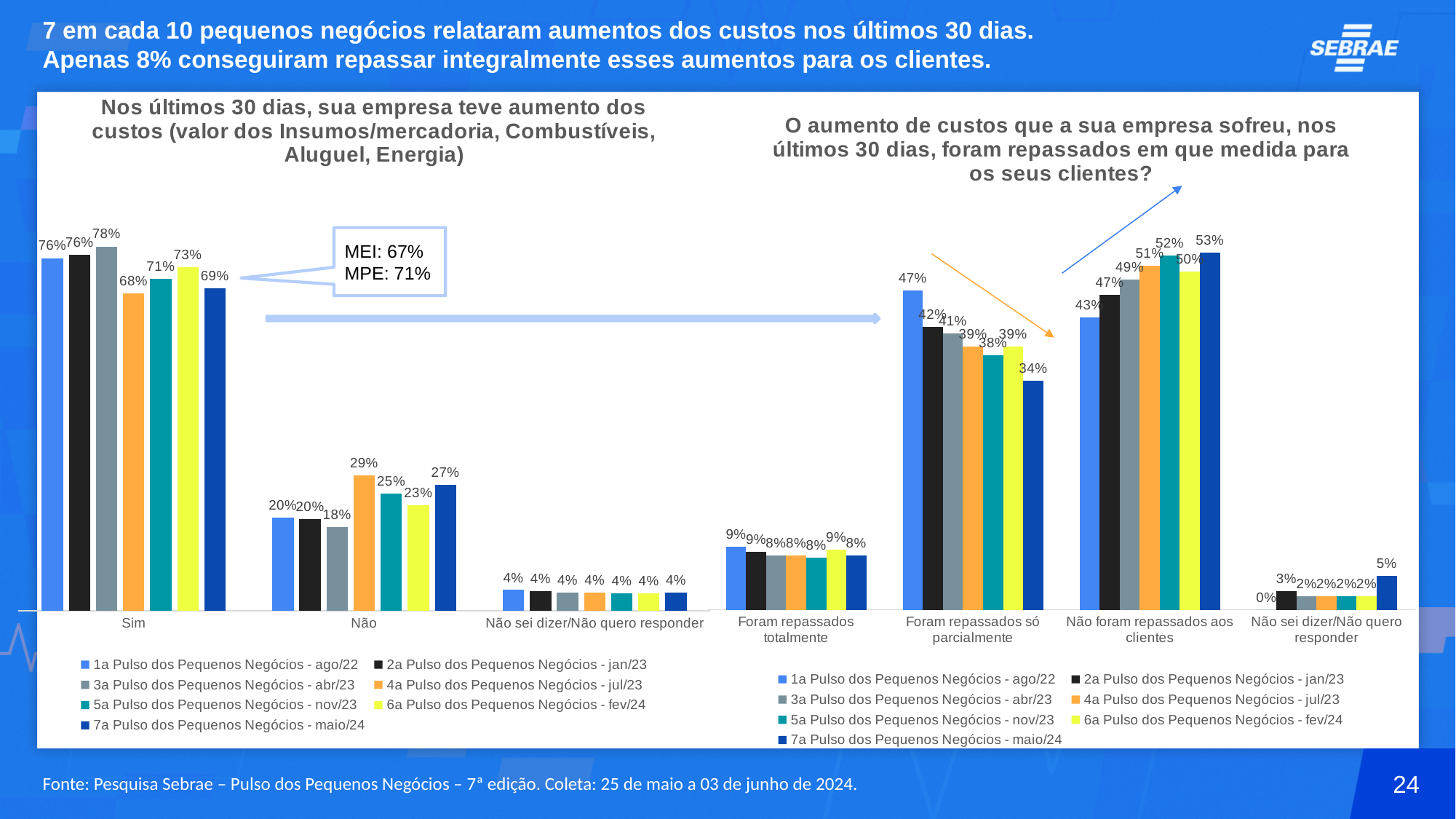
In the left chart, what is the difference between the "Não" values for 7a Pulso - maio/24 and 6a Pulso - fev/24? 4% In the right chart ("O aumento de custos que a sua empresa sofreu..."), what is the value for "Não foram repassados aos clientes" in the 7a Pulso dos Pequenos Negócios - maio/24 series? 53% In the right chart, which series has the lowest value for "Foram repassados só parcialmente"? 7a Pulso dos Pequenos Negócios - maio/24 In the left chart, how many categories are shown on the x axis? 3 How many series does the legend of the right chart list? 7 In the left chart, which series has the highest value for "Sim"? 3a Pulso dos Pequenos Negócios - abr/23 In the right chart, which is larger for the 7a Pulso - maio/24 series: "Foram repassados só parcialmente" or "Não foram repassados aos clientes"? Não foram repassados aos clientes In the left chart ("Nos últimos 30 dias, sua empresa teve aumento dos custos"), what is the value for "Sim" in the 7a Pulso dos Pequenos Negócios - maio/24 series? 69% What type of chart is the right chart? Bar chart In the left chart, what is the value for "Não" in the 4a Pulso dos Pequenos Negócios - jul/23 series? 29% In the left chart, which series has the lowest value for "Sim"? 4a Pulso dos Pequenos Negócios - jul/23 In the right chart, what is the value for "Foram repassados só parcialmente" in the 1a Pulso dos Pequenos Negócios - ago/22 series? 47%